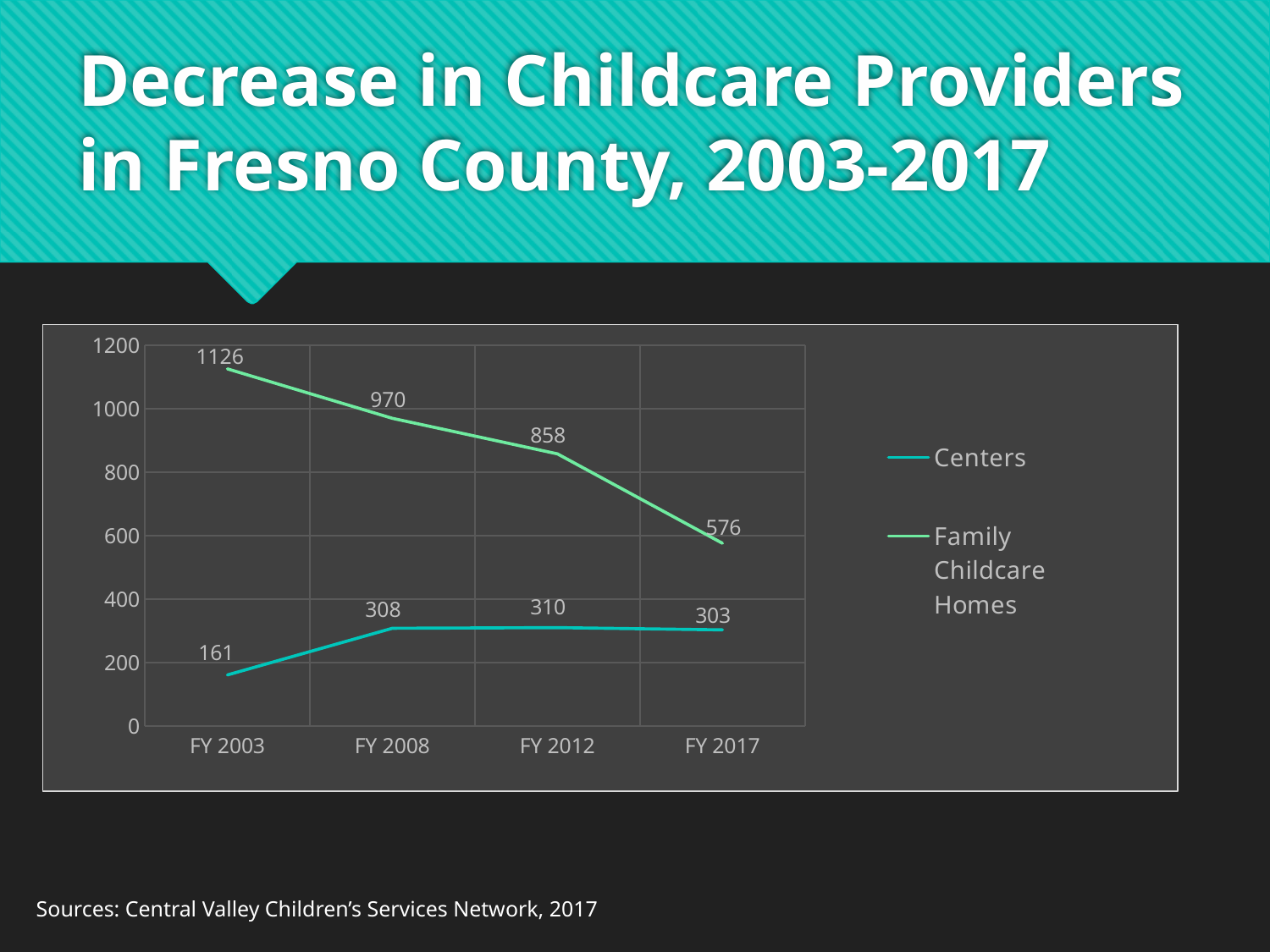
What is the difference between the Family Childcare Homes values in FY 2003 and FY 2017? 550 What is the difference between Family Childcare Homes and Centers in FY 2012? 548 What is the value for Family Childcare Homes in FY 2003? 1126 In which fiscal year is the Centers value lowest? FY 2003 How many series does the legend list? 2 In which fiscal year is the Family Childcare Homes value highest? FY 2003 Which is larger in FY 2017, Centers or Family Childcare Homes? Family Childcare Homes What is the value for Family Childcare Homes in FY 2017? 576 What is the value for Centers in FY 2008? 308 How many fiscal years are shown on the x axis? 4 What type of chart is shown on the slide? line chart Does the Family Childcare Homes series rise or fall from FY 2003 to FY 2017? fall